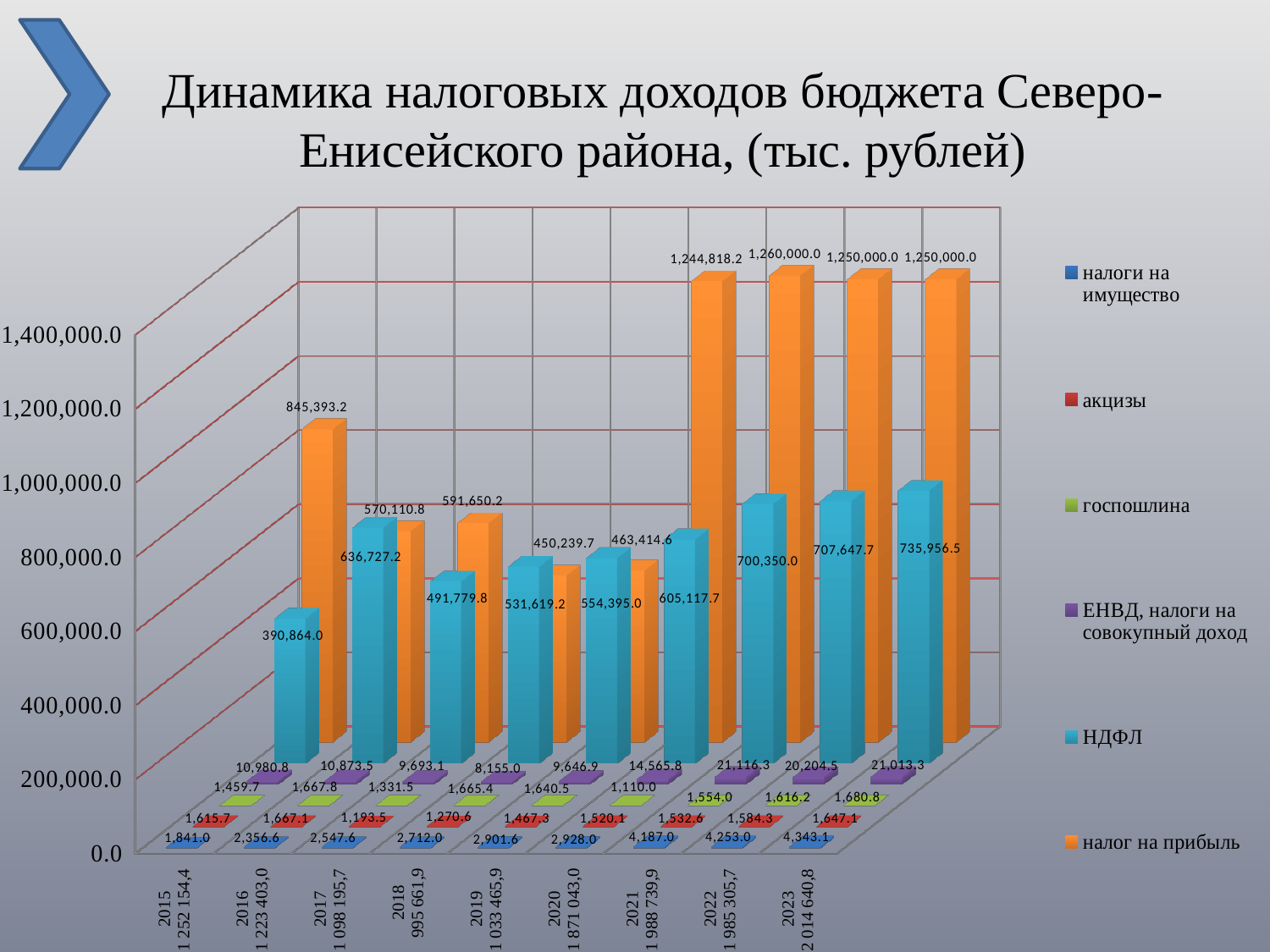
In which year is налог на прибыль highest? 2021 How many series does the legend list? 6 Do the values of налоги на имущество rise or fall from 2015 to 2023? rise What is the difference between НДФЛ in 2023 and in 2022? 28,308.8 What is the value of НДФЛ for 2023? 735,956.5 What kind of chart is shown on the slide? bar chart How many years are shown along the x axis? 9 What is the value of налог на прибыль for 2015? 845,393.2 What is the value of налоги на имущество for 2021? 4,187.0 In which year is НДФЛ lowest? 2015 In which year is налог на прибыль lowest? 2018 Which is larger in 2016: налог на прибыль or НДФЛ? НДФЛ